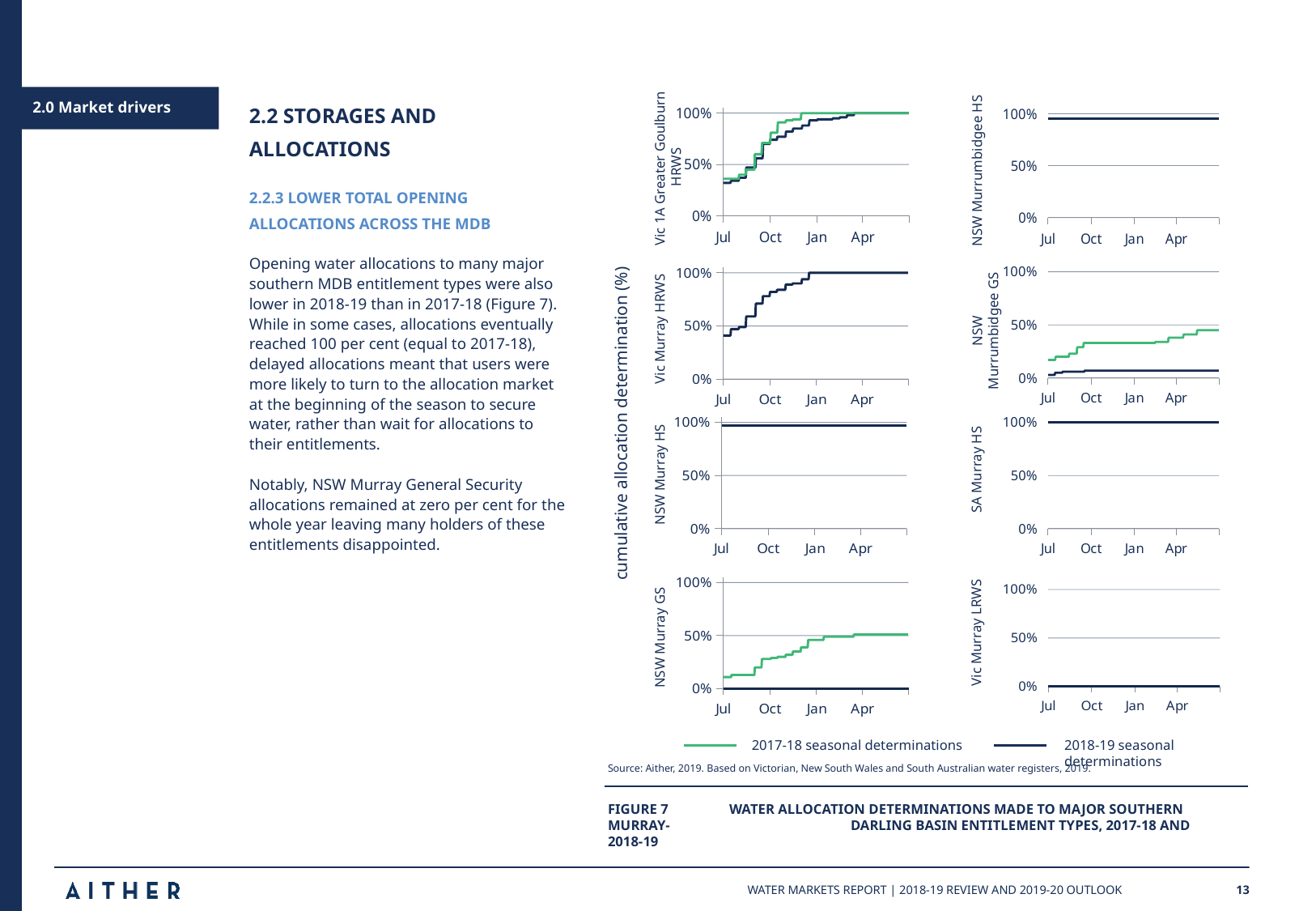
In the Vic Murray LRWS chart, what value does the 2018-19 line sit at? 0% How many series does the legend list? 2 In the Vic Murray HRWS chart, is the 2018-19 value in Jul greater or less than 50%? less In the NSW Murrumbidgee HS chart, is the 2018-19 value greater or less than 50%? greater In the SA Murray HS chart, what value do both series sit at? 100% In the Vic Murray HRWS chart, does the 2018-19 line rise or fall from Jul to Jan? rise In the NSW Murray GS chart, what is the cumulative allocation determination for 2018-19 across the whole year? 0% How many small charts (panels) are shown in Figure 7? 8 Which series is drawn in green according to the legend? 2017-18 seasonal determinations In the NSW Murrumbidgee GS chart, which series is higher in Apr, 2017-18 or 2018-19? 2017-18 In the NSW Murrumbidgee GS chart, is the 2017-18 value in Oct greater or less than 50%? less What kind of chart is used for the Vic Murray HRWS panel? line chart